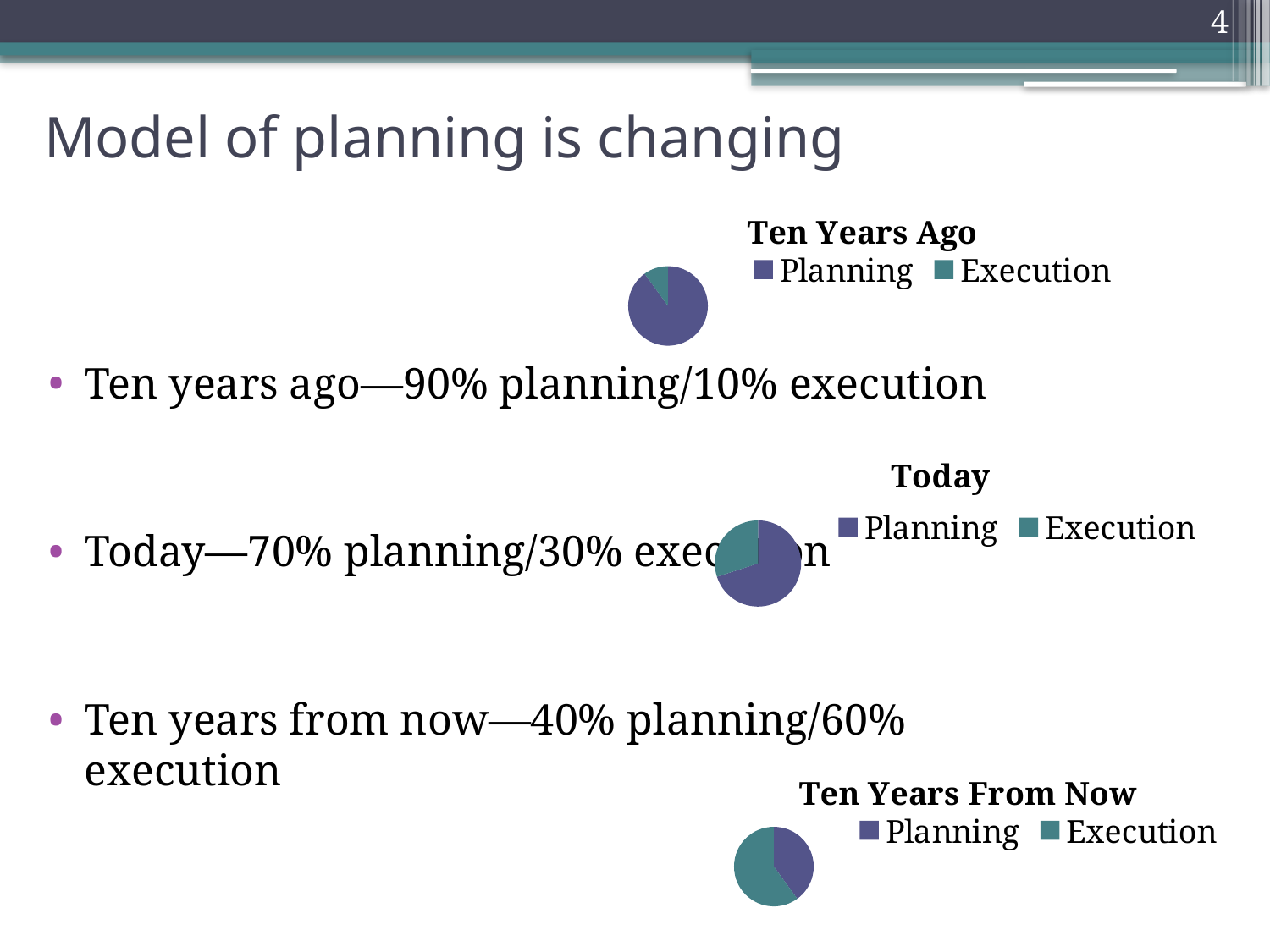
In the "Ten Years Ago" chart, which slice is larger, Planning or Execution? Planning What kind of chart is the "Ten Years Ago" chart? pie chart Across the three charts from "Ten Years Ago" to "Ten Years From Now", does the Planning share rise or fall? fall In the "Today" chart, which slice is larger, Planning or Execution? Planning In the "Ten Years From Now" chart, which slice is larger, Planning or Execution? Execution In the "Ten Years Ago" chart, what share of the pie is Planning? 90% How many pie charts are shown on the slide? 3 How many series does the legend of the "Today" chart list? 2 In the "Today" chart, what share of the pie is Execution? 30% What are the two legend entries of the "Ten Years Ago" chart? Planning and Execution What is the title of the bottom pie chart on the slide? Ten Years From Now In the "Ten Years From Now" chart, what share of the pie is Execution? 60%